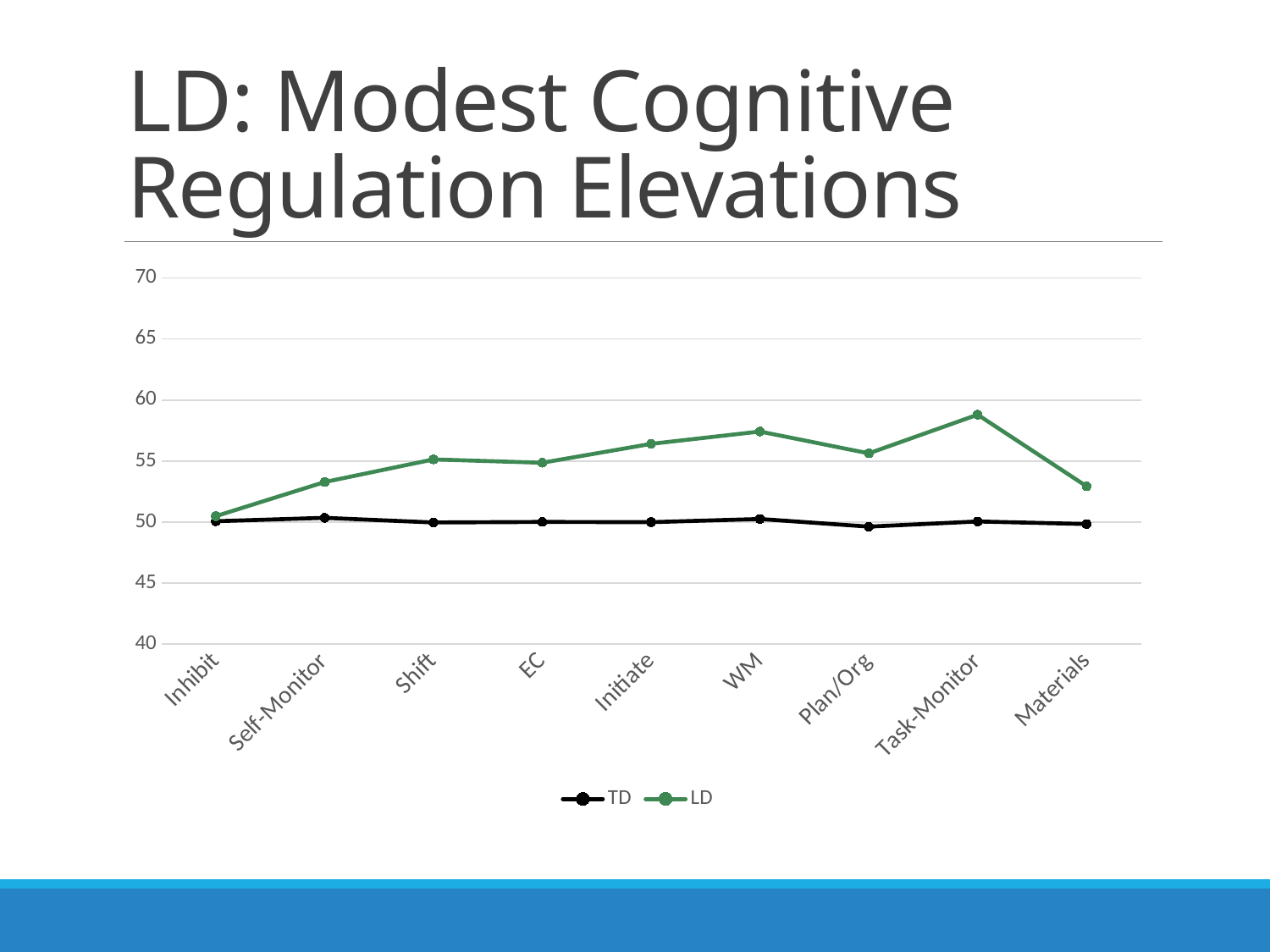
How many categories are plotted along the x axis? 9 Does the LD line rise or fall from Task-Monitor to Materials? fall Is the LD value for Task-Monitor greater or less than 55? greater How many series does the legend list? 2 What colour is the LD line in the chart? green For the LD series, which category has the lowest value? Inhibit What kind of chart is shown on the slide? line chart At Task-Monitor, which series has the larger value, TD or LD? LD For the LD series, which category has the highest value? Task-Monitor Is the TD value for WM greater or less than 55? less Is the LD value for Inhibit greater or less than 55? less